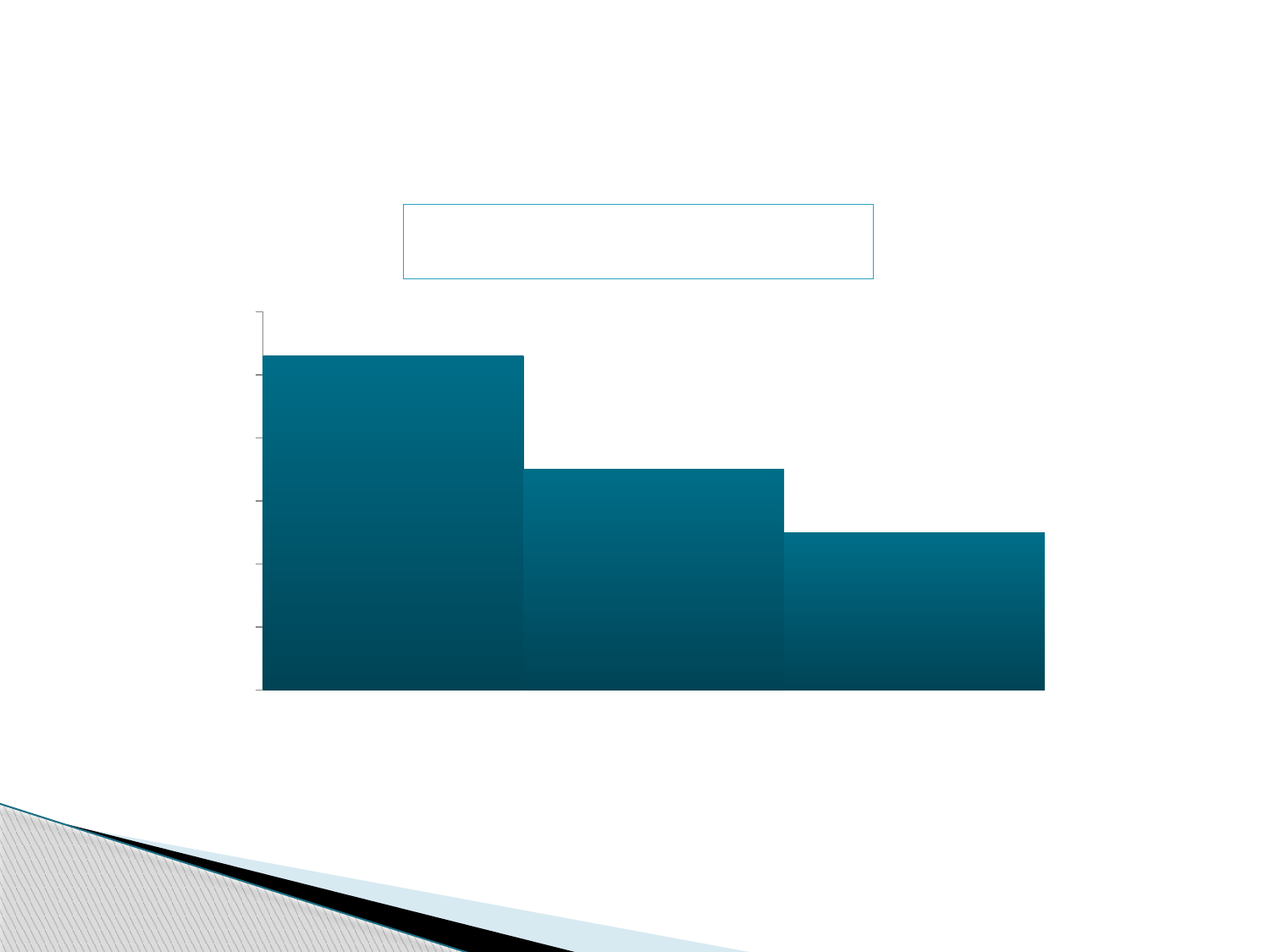
Which bar is the tallest: the leftmost, middle, or rightmost? leftmost Is the rightmost bar taller or shorter than the middle bar? shorter What kind of chart is shown on the slide? bar chart Which bar is the shortest: the leftmost, middle, or rightmost? rightmost How many bars does the chart show? 3 Is the leftmost bar taller or shorter than the middle bar? taller Are the bars in the chart vertical or horizontal? vertical Do the bar values rise or fall from left to right across the chart? fall